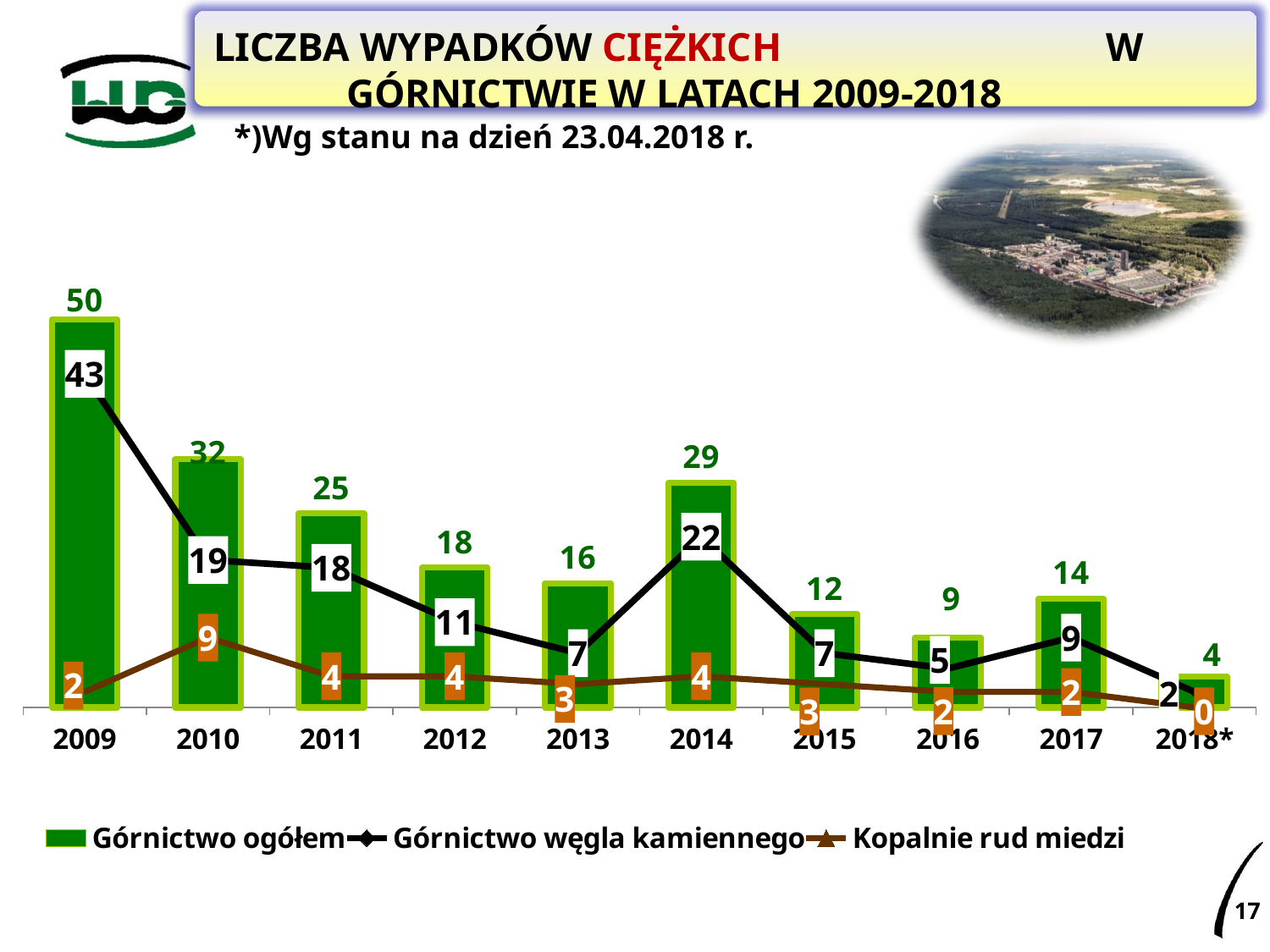
What is the value of Kopalnie rud miedzi for 2018*? 0 Which year has the highest value for Górnictwo ogółem? 2009 Which is larger: the Górnictwo węgla kamiennego value for 2013 or for 2014? 2014 How many series does the legend list? 3 What is the value of Górnictwo ogółem for 2009? 50 What is the value of Górnictwo węgla kamiennego for 2014? 22 How many years are shown on the x axis? 10 What is the difference between the Górnictwo ogółem values for 2009 and 2010? 18 Do the Górnictwo ogółem values generally rise or fall from 2009 to 2018*? Fall Which year has the lowest value for Górnictwo ogółem? 2018* What kind of chart is shown on the slide? Combined bar and line chart What is the value of Kopalnie rud miedzi for 2010? 9